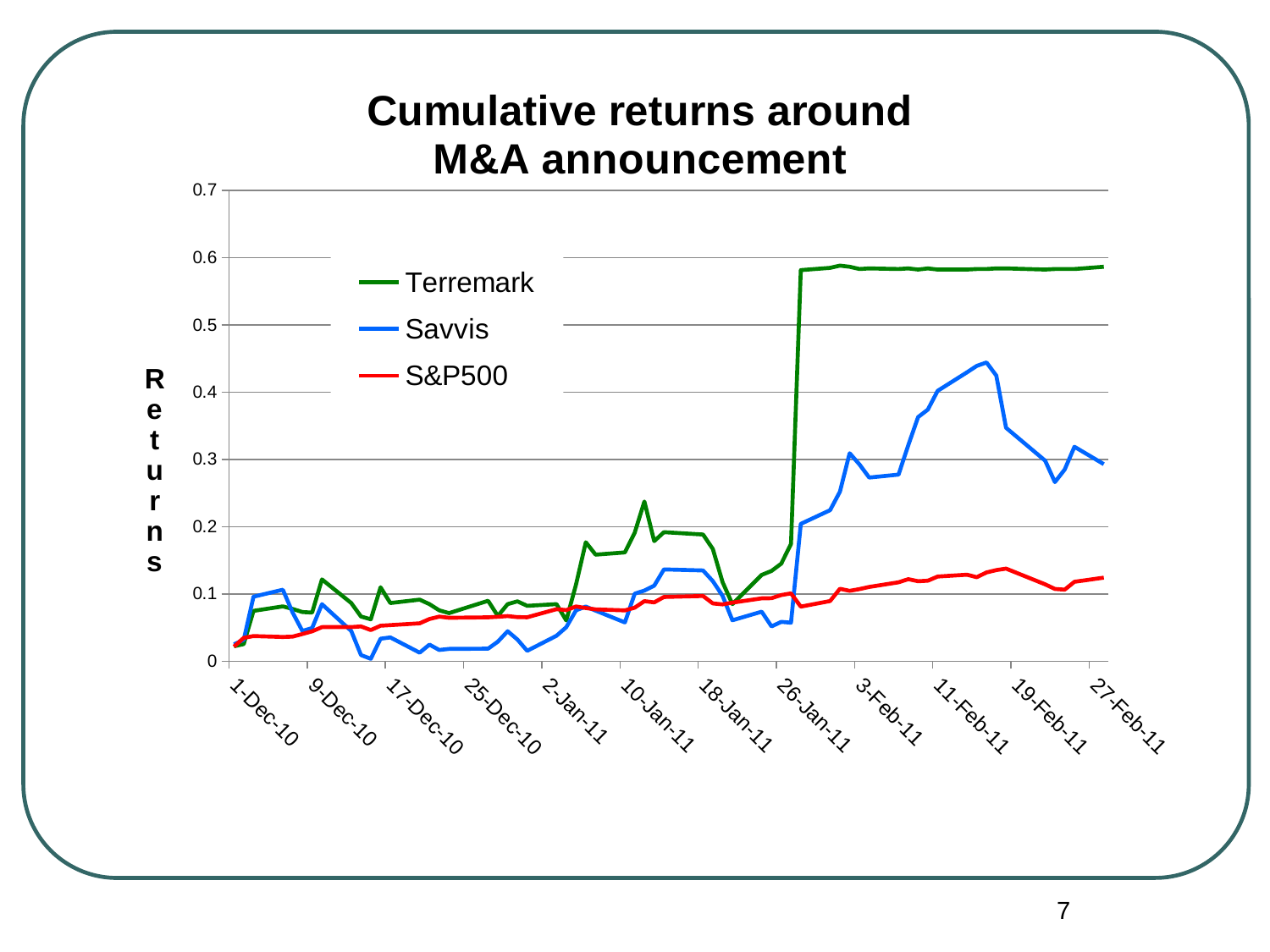
Which series has the lowest value at 27-Feb-11? S&P500 Does the S&P500 line generally rise or fall from 1-Dec-10 to 27-Feb-11? rise Is the value for Terremark at 27-Feb-11 greater or less than 0.5? greater How many date labels are shown on the x axis? 12 What is the title of the chart? Cumulative returns around M&A announcement At 27-Feb-11, which is larger, the Terremark value or the Savvis value? Terremark Which colour is used for the Savvis line? blue Is the value for S&P500 at 27-Feb-11 greater or less than 0.2? less Which series has the highest value at 27-Feb-11? Terremark What kind of chart is shown on the slide? line chart How many series does the legend list? 3